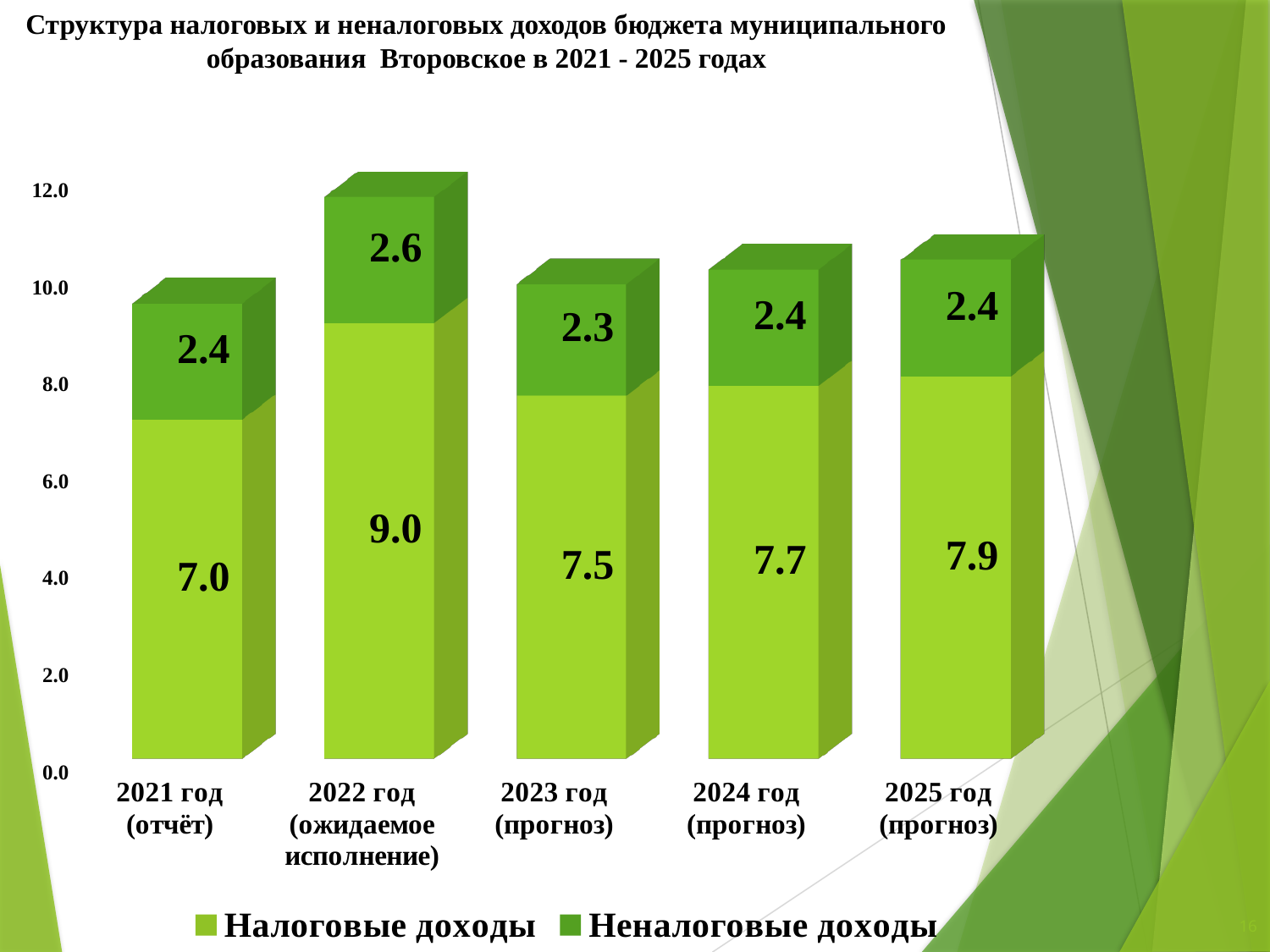
Which year has the highest value of Налоговые доходы? 2022 год (ожидаемое исполнение) What is the value of Налоговые доходы for 2025 год (прогноз)? 7.9 What is the value of Неналоговые доходы for 2022 год (ожидаемое исполнение)? 2.6 What is the difference between Налоговые доходы in 2022 год and 2021 год? 2.0 What is the total of the stacked bar for 2022 год (ожидаемое исполнение)? 11.6 What kind of chart is shown on the slide? Stacked bar chart Which is larger: Налоговые доходы in 2024 год (прогноз) or in 2023 год (прогноз)? 2024 год (прогноз) What is the value of Налоговые доходы for 2021 год (отчёт)? 7.0 How many years are shown on the x axis? 5 How many series does the legend list? 2 What is the total of the stacked bar for 2025 год (прогноз)? 10.3 Which year has the lowest value of Неналоговые доходы? 2023 год (прогноз)